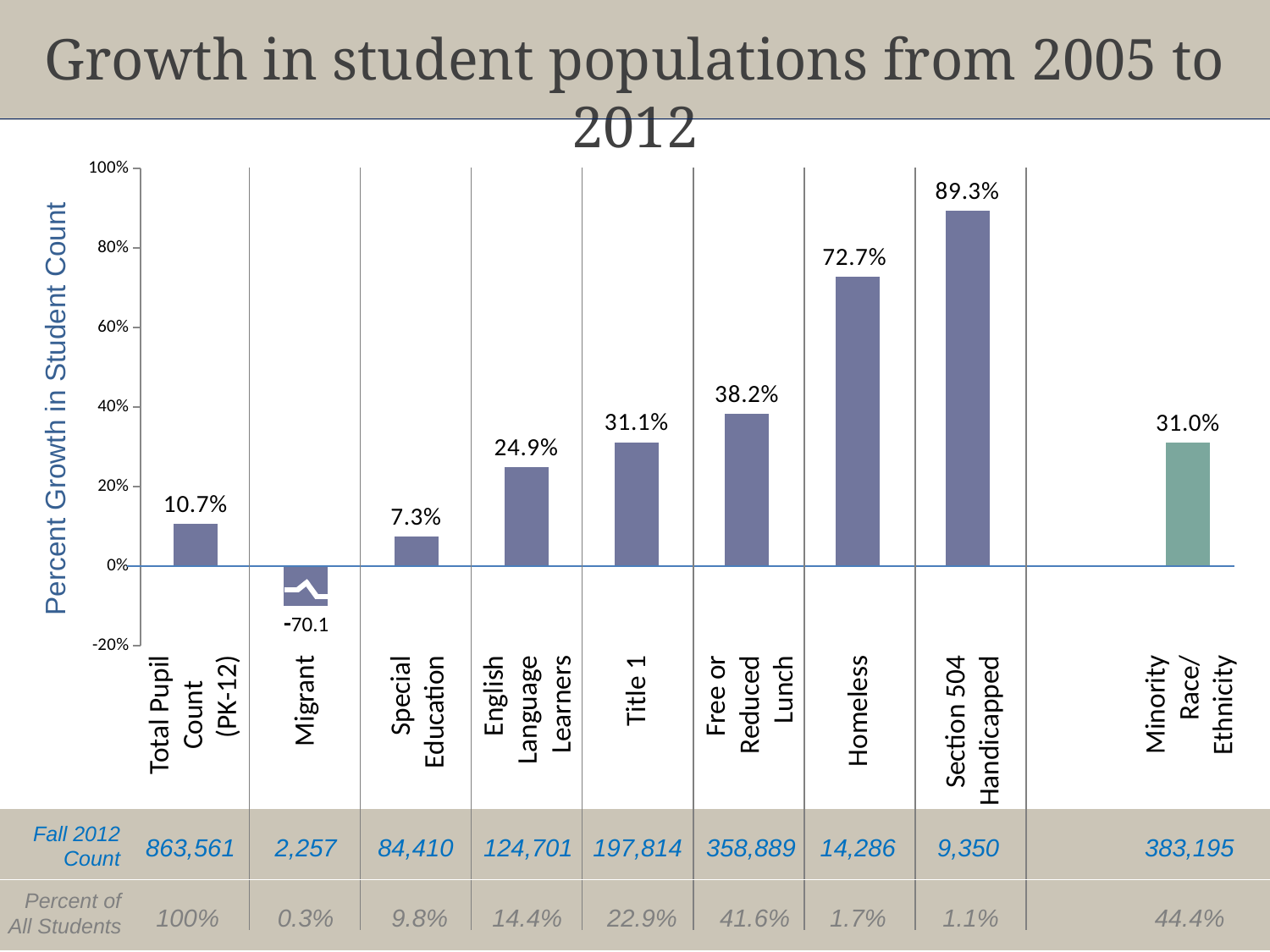
What is the difference in percent growth between Section 504 Handicapped and Homeless? 16.6% What is the percent growth in student count for Special Education? 7.3% Is the percent growth for Homeless students greater or less than 60%? greater What is the percent growth in student count for Section 504 Handicapped? 89.3% What is the percent growth in student count for English Language Learners? 24.9% What is the label of the vertical axis? Percent Growth in Student Count Which has a larger percent growth, Free or Reduced Lunch or Title 1? Free or Reduced Lunch What kind of chart is shown on the slide? bar chart How many categories are plotted in the chart? 9 Which category shows the highest percent growth in student count? Section 504 Handicapped Which category shows the lowest percent growth in student count? Migrant What is the percent growth in student count for Homeless students? 72.7%